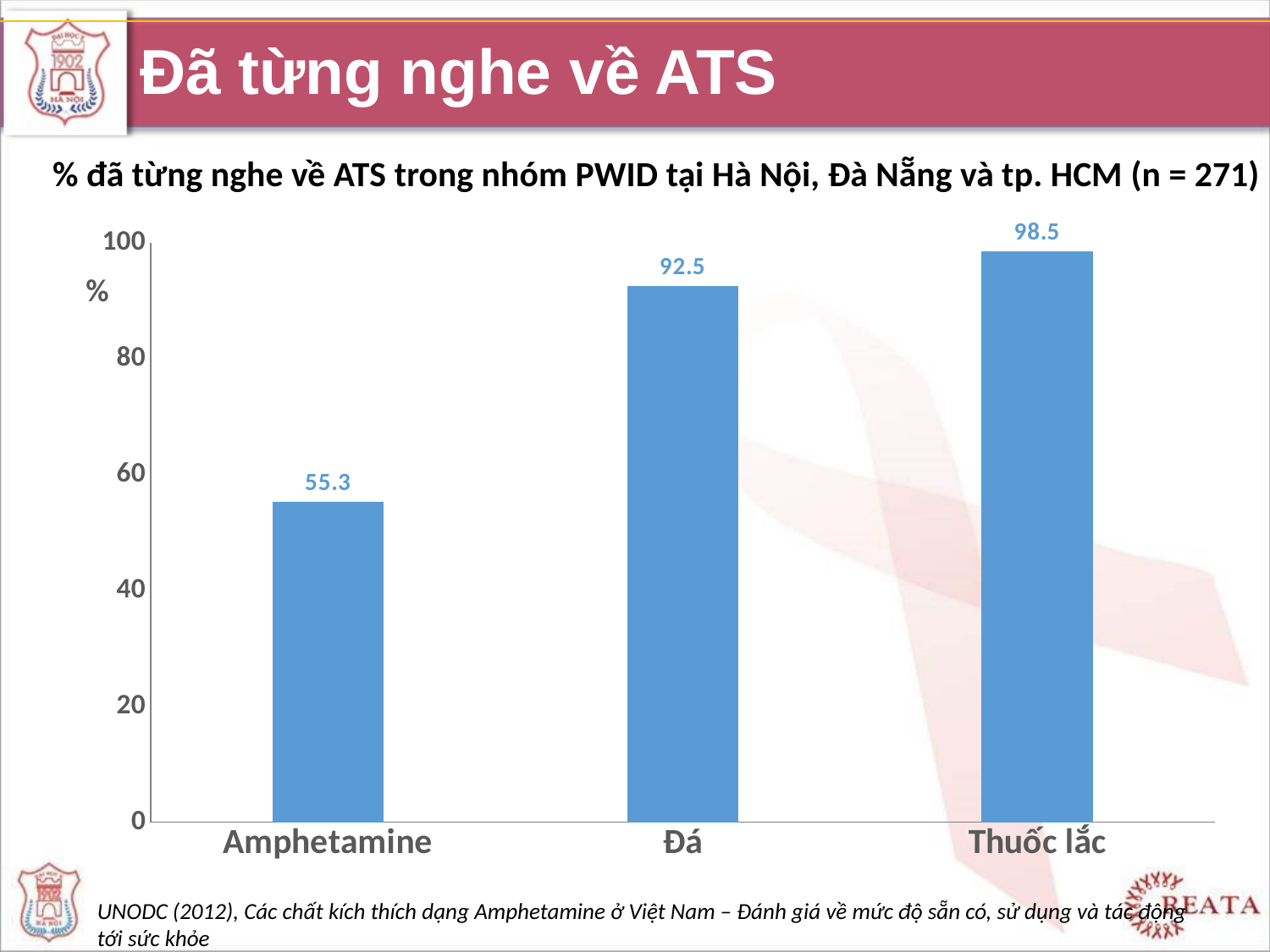
Which category has the highest value? Thuốc lắc Is the value for Amphetamine greater or less than 60? less What is the difference between the values for Đá and Amphetamine? 37.2 What is the value for Đá? 92.5 Which category has the lowest value? Amphetamine What is the value for Amphetamine? 55.3 What kind of chart is shown on the slide? bar chart How many categories are shown on the x axis? 3 Which is larger, the value for Amphetamine or the value for Đá? Đá What is the difference between the values for Thuốc lắc and Đá? 6 Do the values rise or fall from left to right along the x axis? rise What is the value for Thuốc lắc? 98.5